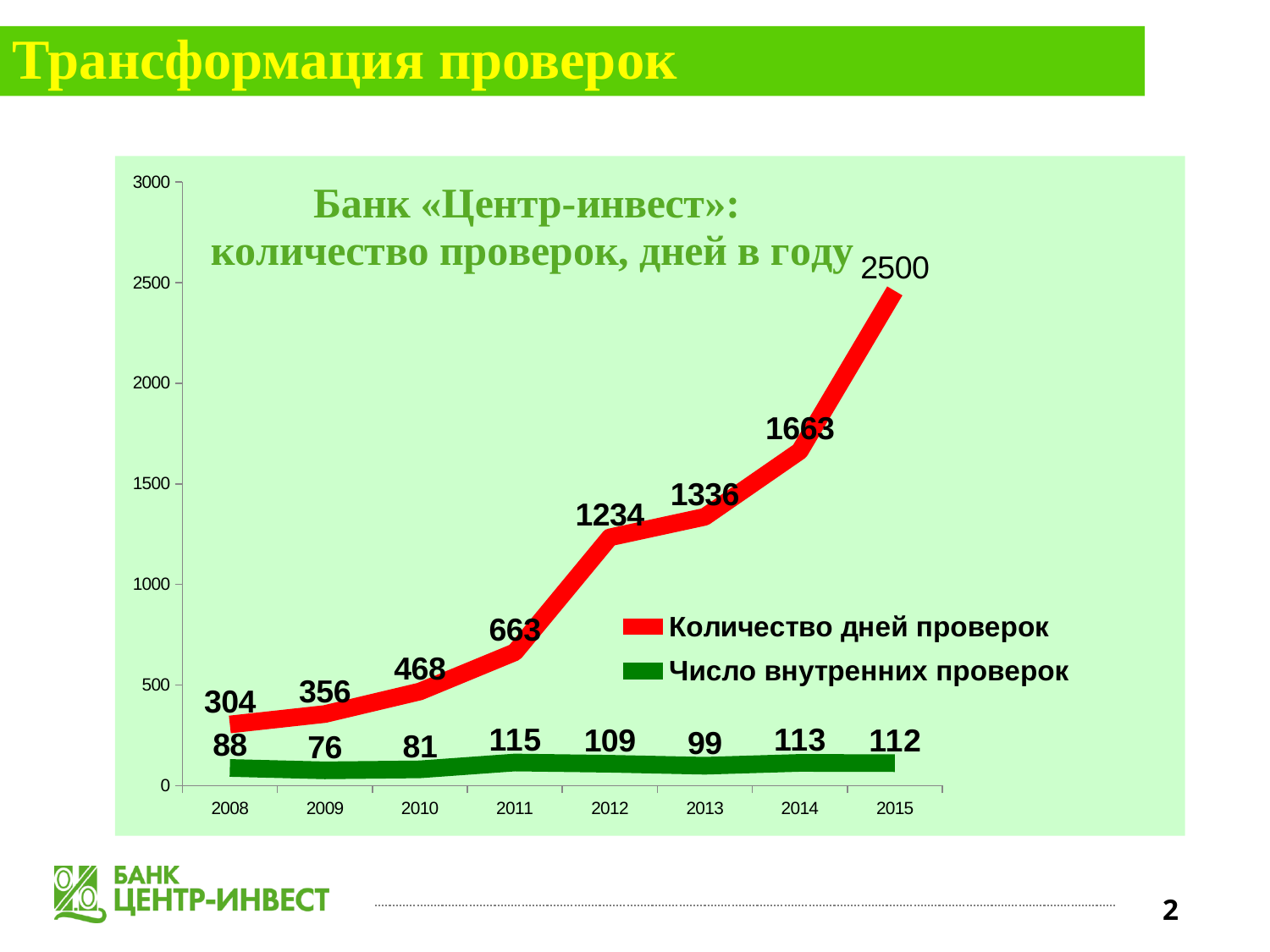
What is the value of "Количество дней проверок" in 2015? 2500 In which year is "Число внутренних проверок" highest? 2011 Is the value of "Количество дней проверок" in 2011 greater or less than 500? greater How many years are shown on the x axis? 8 What is the value of "Количество дней проверок" in 2012? 1234 How many series does the legend list? 2 Which is larger: "Число внутренних проверок" in 2012 or in 2013? 2012 In which year is "Количество дней проверок" lowest? 2008 Does "Количество дней проверок" rise or fall from 2008 to 2015? rise What kind of chart is this? line chart What is the difference between "Количество дней проверок" in 2014 and in 2013? 327 What is the value of "Число внутренних проверок" in 2009? 76